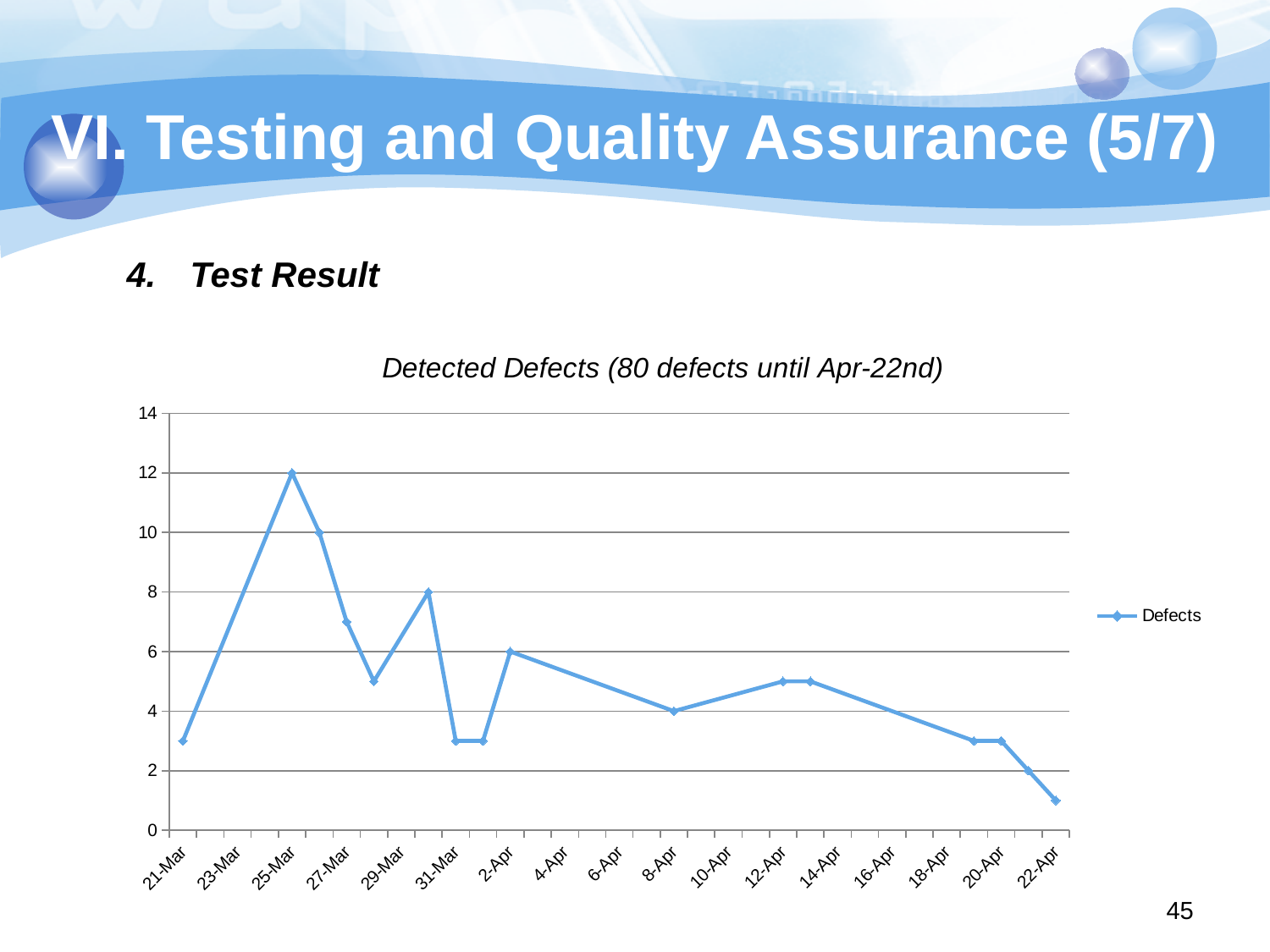
Is the value for 12-Apr greater or less than 4? greater How many series does the legend list? 1 What is the title of the chart? Detected Defects (80 defects until Apr-22nd) What is the number of defects on 8-Apr? 4 What type of chart is shown on the slide? Line chart What is the name of the series shown in the legend? Defects What is the difference between the defects on 25-Mar and on 8-Apr? 8 On which date does the number of defects reach its highest value? 25-Mar What is the number of defects on 25-Mar? 12 Is the value for 21-Mar greater or less than 4? less What is the number of defects on 2-Apr? 6 On which date is the number of defects lowest? 22-Apr